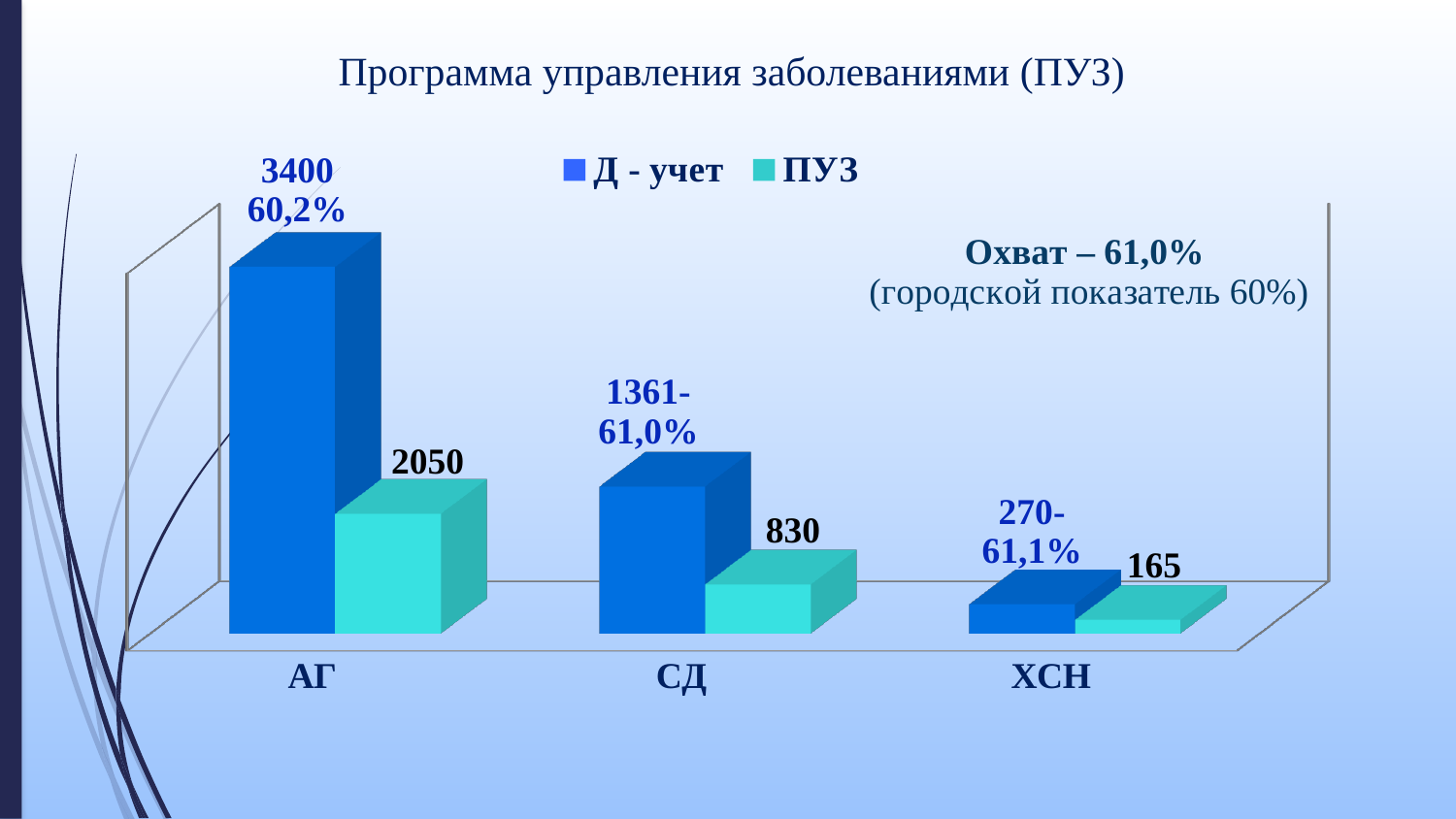
How many categories are shown on the x axis? 3 What kind of chart is shown on the slide? Bar chart What is the value of the ПУЗ series for СД? 830 Which category has the lowest ПУЗ value? ХСН What is the value of the Д - учет series for ХСН? 270 What is the value of the ПУЗ series for АГ? 2050 What is the value of the ПУЗ series for ХСН? 165 How many series does the legend list? 2 Which category has the highest Д - учет value? АГ What is the difference between the Д - учет and ПУЗ values for СД? 531 What is the value of the Д - учет series for АГ? 3400